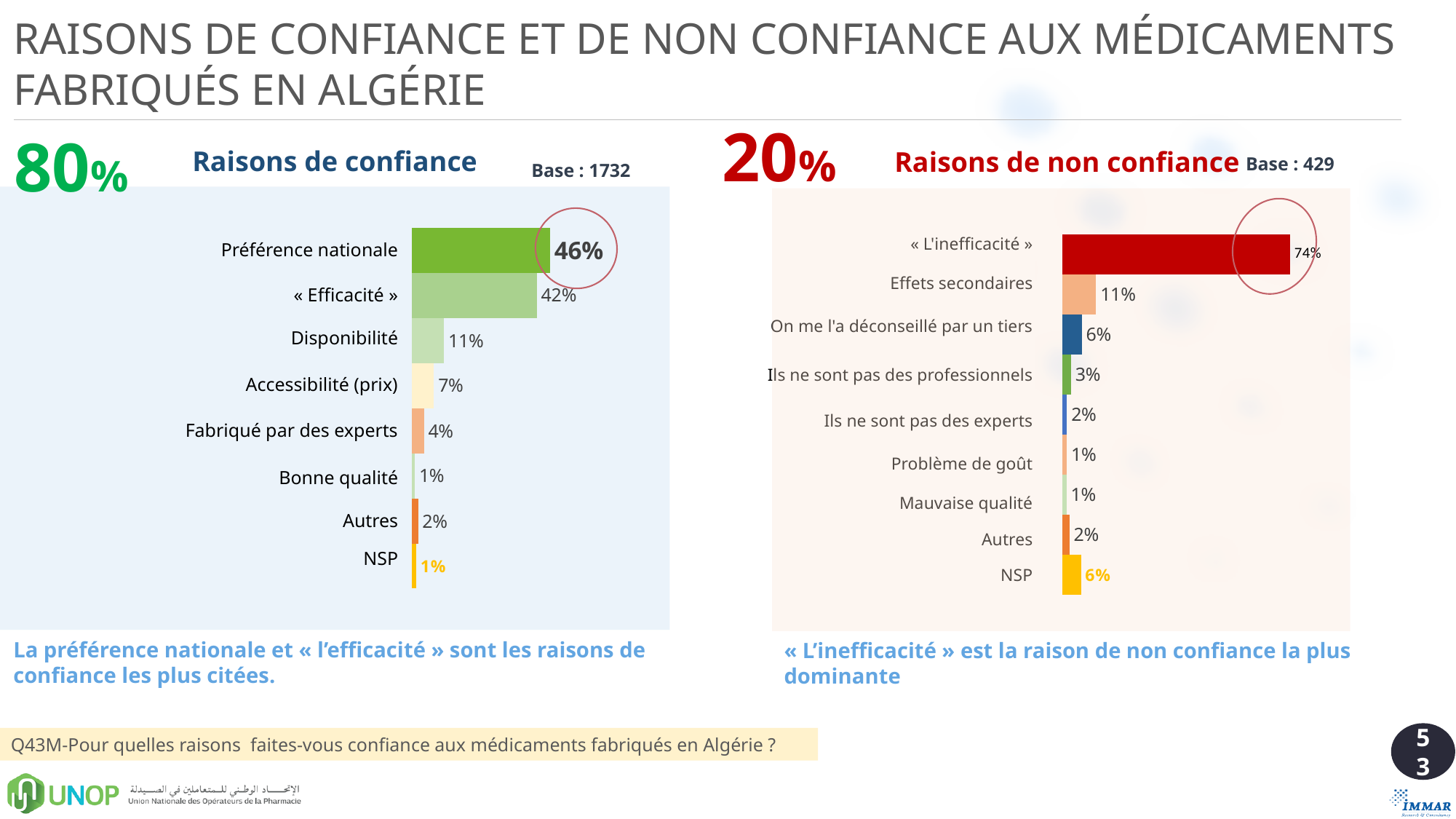
In the "Raisons de non confiance" chart, which category has the highest value? « L'inefficacité » In the "Raisons de confiance" chart, which is larger: Accessibilité (prix) or Fabriqué par des experts? Accessibilité (prix) In the "Raisons de non confiance" chart, what is the value for On me l'a déconseillé par un tiers? 6% In the "Raisons de confiance" chart, what is the value for Préférence nationale? 46% In the "Raisons de confiance" chart, what is the value for Disponibilité? 11% In the "Raisons de non confiance" chart, what is the difference between « L'inefficacité » and Effets secondaires? 63% In the "Raisons de confiance" chart, which category has the highest value? Préférence nationale In the "Raisons de confiance" chart, what is the difference between Préférence nationale and « Efficacité »? 4% How many categories are shown in the "Raisons de confiance" chart? 8 What type of chart is the "Raisons de confiance" chart? Bar chart In the "Raisons de non confiance" chart, what is the value for « L'inefficacité »? 74% How many categories are shown in the "Raisons de non confiance" chart? 9